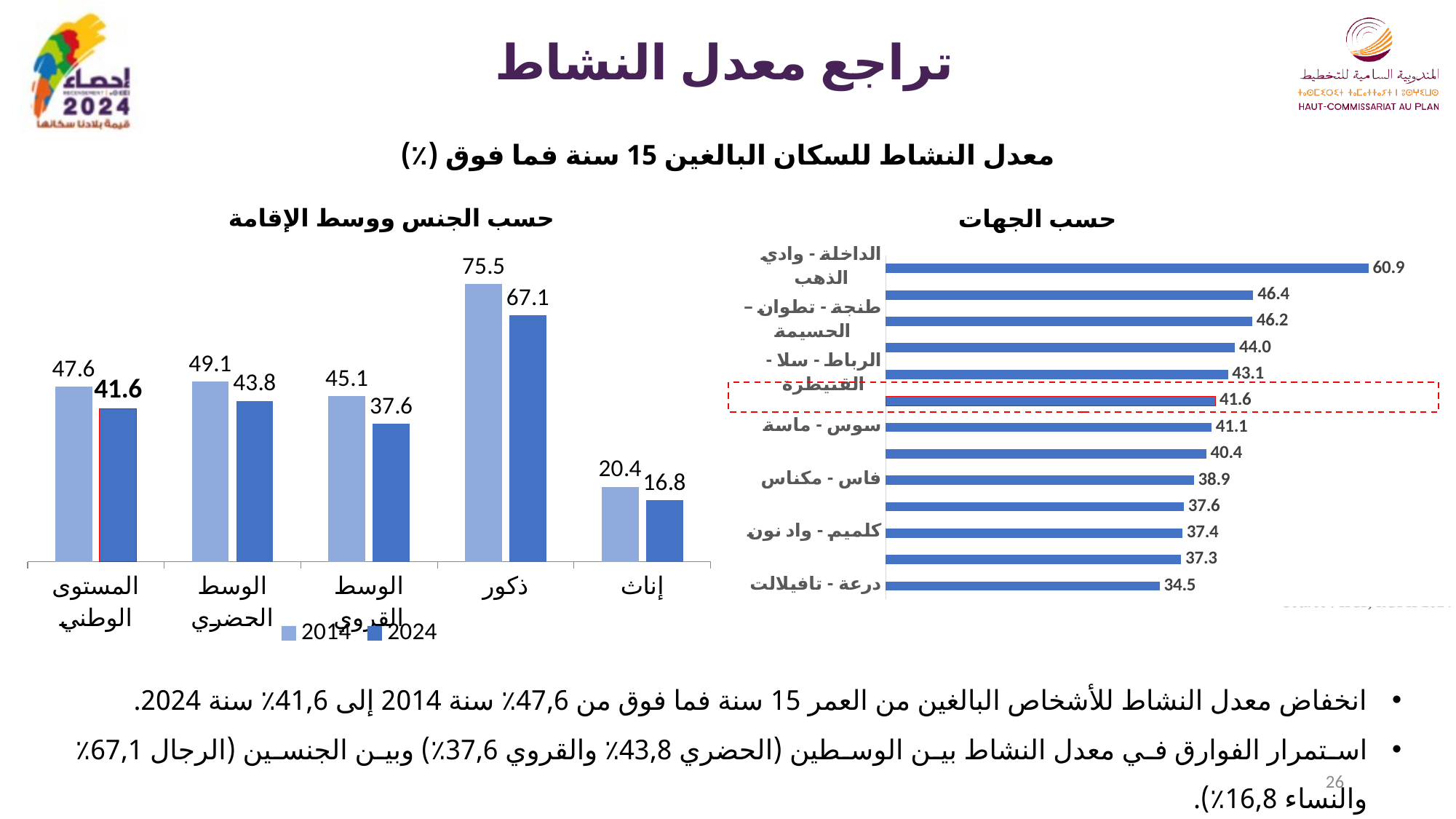
In the chart titled حسب الجنس ووسط الإقامة, which category has the lowest 2024 value? إناث In the chart titled حسب الجهات, what is the highest value shown? 60.9 In the chart titled حسب الجنس ووسط الإقامة, what is the 2024 value for إناث? 16.8 In the chart titled حسب الجنس ووسط الإقامة, what is the 2024 value for المستوى الوطني? 41.6 In the chart titled حسب الجنس ووسط الإقامة, how many series does the legend list? 2 In the chart titled حسب الجنس ووسط الإقامة, how many categories are shown on the x axis? 5 In the chart titled حسب الجنس ووسط الإقامة, which is larger: the 2024 value for الوسط الحضري or the 2024 value for الوسط القروي? الوسط الحضري In the chart titled حسب الجهات, what is the value for درعة - تافيلالت? 34.5 In the chart titled حسب الجنس ووسط الإقامة, what is the 2014 value for ذكور? 75.5 What kind of chart is the chart titled حسب الجهات? Bar chart In the chart titled حسب الجهات, what is the value for الداخلة - وادي الذهب? 60.9 In the chart titled حسب الجنس ووسط الإقامة, what is the difference between the 2014 and 2024 values for الوسط القروي? 7.5